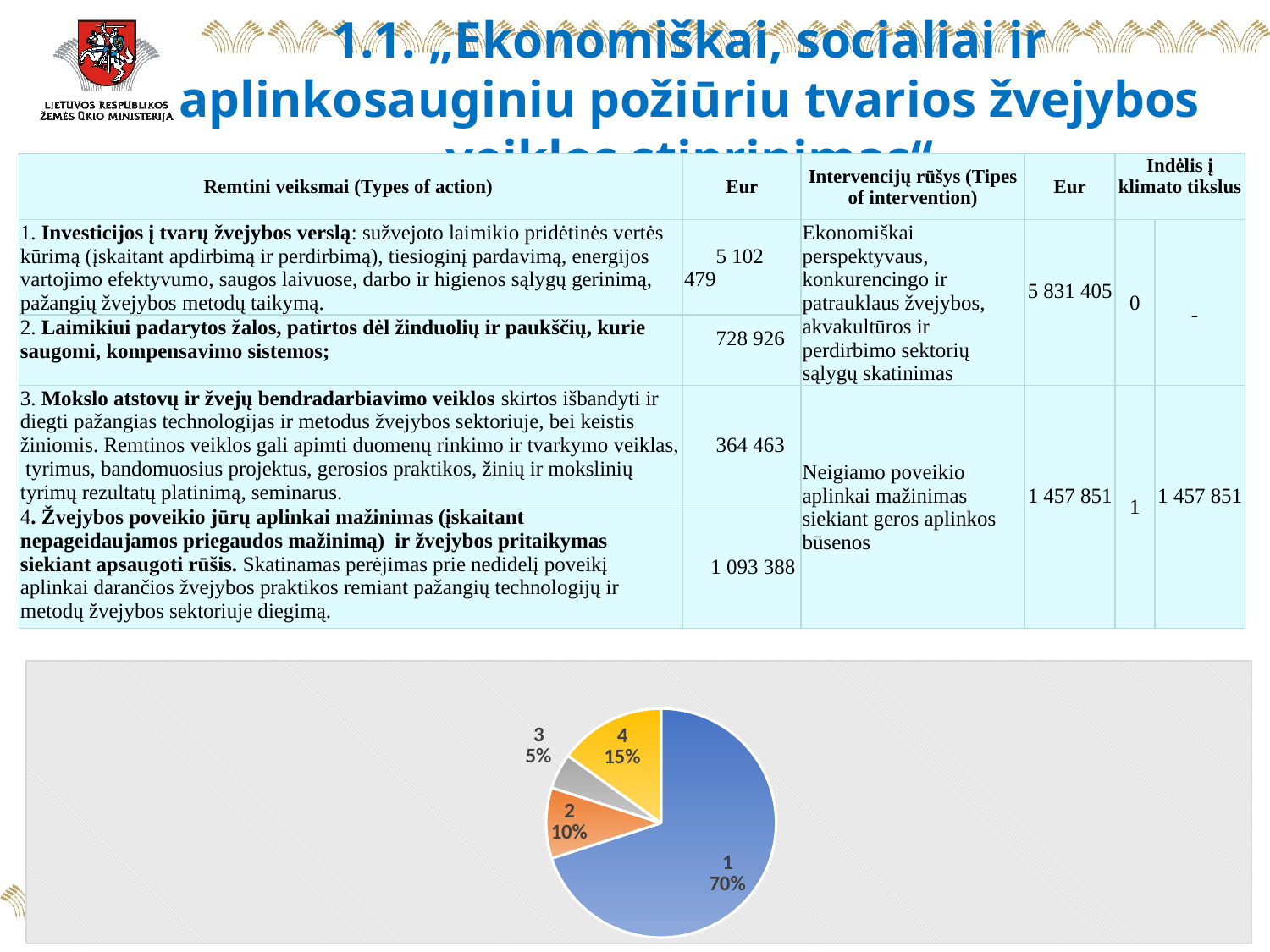
What share of the pie does slice 3 represent? 5% What share of the pie does slice 2 represent? 10% What share of the pie does slice 4 represent? 15% Which is larger in the pie chart, slice 2 or slice 4? 4 Which slice of the pie chart is the largest? 1 What is the difference in percentage points between slice 1 and slice 4 in the pie chart? 55 What colour is the largest slice of the pie chart? blue What kind of chart is shown at the bottom of the slide? pie chart Which slice of the pie chart is the smallest? 3 How many slices does the pie chart have? 4 What is the difference in percentage points between slice 2 and slice 3 in the pie chart? 5